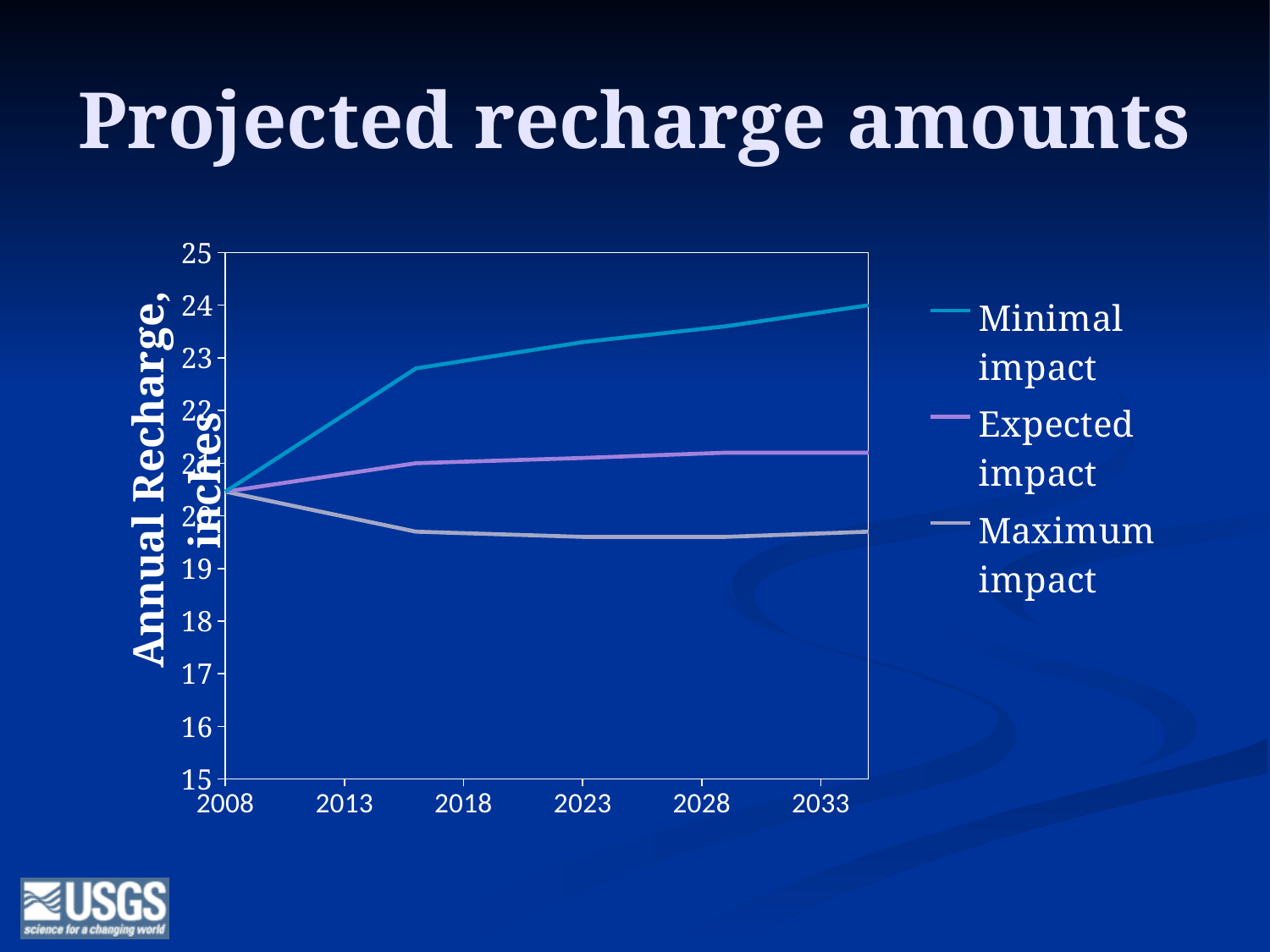
How many series does the legend list? 3 What is the title of the slide's chart? Projected recharge amounts Which series has the lowest value at 2033? Maximum impact Does the Minimal impact line rise or fall from 2008 to 2033? rise Is the value for Maximum impact at 2023 greater or less than 20? less Which series has the highest value at 2033? Minimal impact Is the value for Minimal impact at 2033 greater or less than 23? greater What is the label on the vertical axis? Annual Recharge, inches Does the Maximum impact line rise or fall from 2008 to 2018? fall Is the value for Expected impact at 2028 greater or less than 22? less What kind of chart is shown on the slide? line chart At 2023, which is larger: the Expected impact value or the Maximum impact value? Expected impact